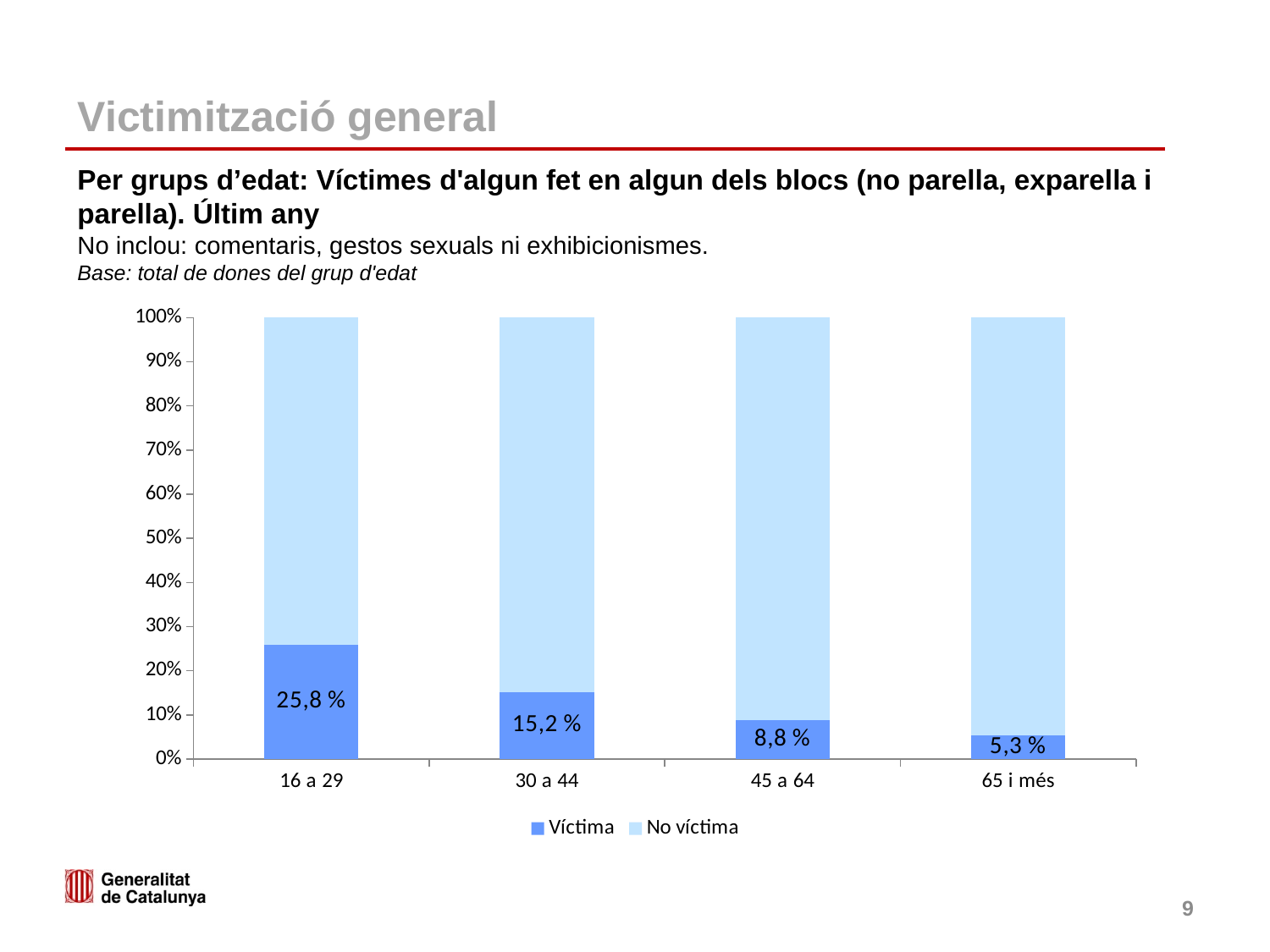
Which age group has the highest Víctima percentage? 16 a 29 How many series does the legend list? 2 What is the Víctima value for the 65 i més age group? 5,3 % What is the difference between the Víctima values for 16 a 29 and 30 a 44? 10,6 % Is the Víctima value for 16 a 29 greater or less than 20%? greater What kind of chart is shown on the slide? Stacked bar chart Which has a larger Víctima value, 30 a 44 or 45 a 64? 30 a 44 Which age group has the lowest Víctima percentage? 65 i més What is the Víctima value for the 45 a 64 age group? 8,8 % How many age groups are shown on the x axis? 4 Does the Víctima percentage rise or fall as age group increases along the x axis? Fall What is the Víctima value for the 16 a 29 age group? 25,8 %